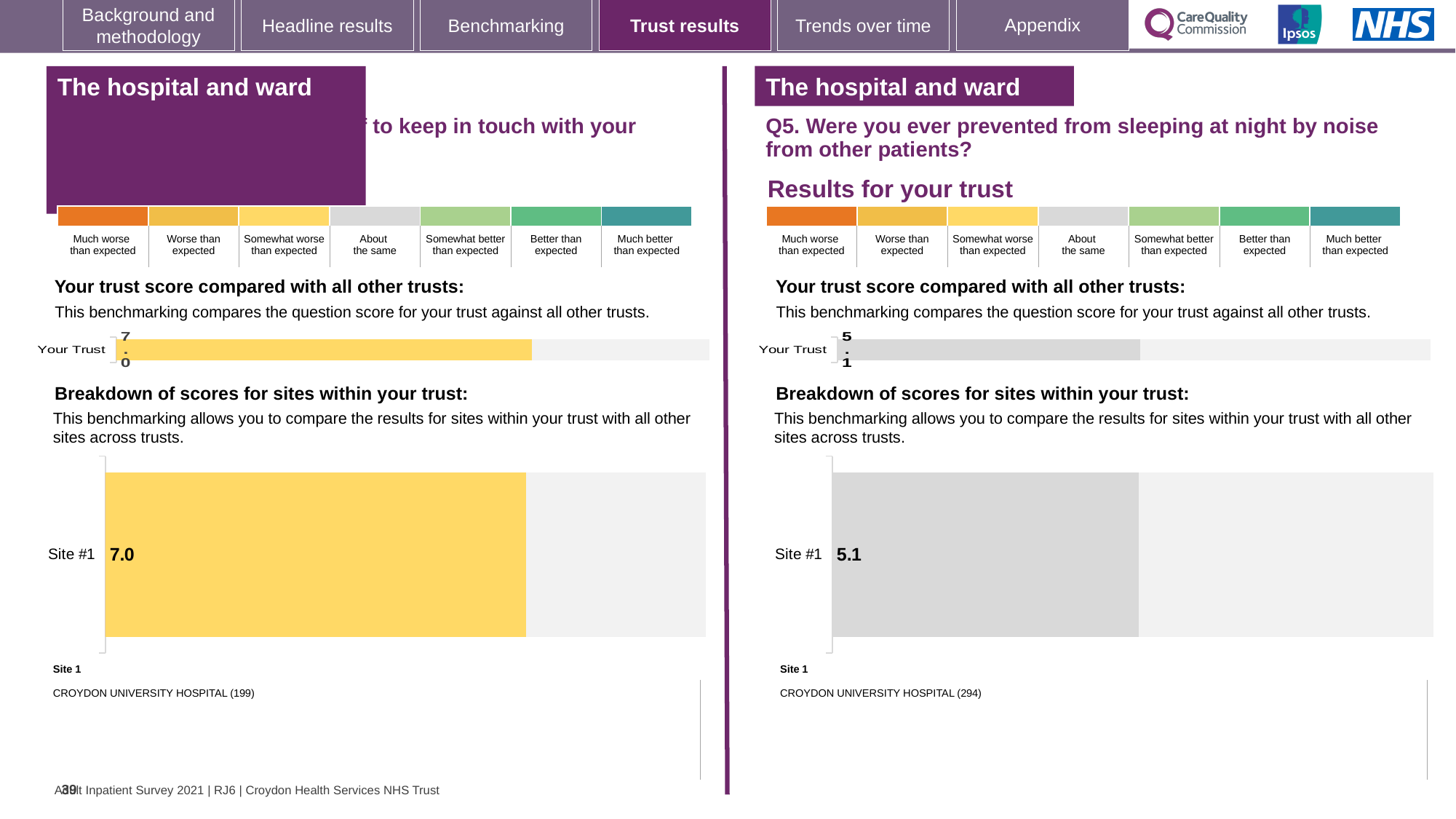
Which is larger: the Site #1 score in the left-hand breakdown chart or the Site #1 score in the right-hand (Q5) breakdown chart? The left-hand chart (7.0) Which site name is listed as Site 1 beneath the right-hand (Q5) breakdown chart? CROYDON UNIVERSITY HOSPITAL (294) According to the colour key, which benchmarking category does the grey colour of the Q5 Site #1 bar on the right-hand side represent? About the same How many sites are shown in the left-hand 'Breakdown of scores for sites within your trust' chart? 1 How many sites are shown in the right-hand (Q5) 'Breakdown of scores for sites within your trust' chart? 1 On the left-hand side of the slide, what score is shown for Site #1 in the 'Breakdown of scores for sites within your trust' chart? 7.0 What type of chart is used to show the Site #1 score in the right-hand (Q5) breakdown section? Bar chart On the right-hand side of the slide (Q5), what score is shown for Site #1 in the 'Breakdown of scores for sites within your trust' chart? 5.1 What is the difference between the Site #1 score in the left-hand breakdown chart (7.0) and the Site #1 score in the right-hand Q5 breakdown chart (5.1)? 1.9 According to the colour key, which benchmarking category does the yellow colour of the Site #1 bar on the left-hand side represent? Somewhat worse than expected On the right-hand side of the slide (Q5), what is the value shown for Your Trust in the 'Your trust score compared with all other trusts' chart? 5.1 On the left-hand side of the slide, what is the value shown for Your Trust in the 'Your trust score compared with all other trusts' chart? 7.0